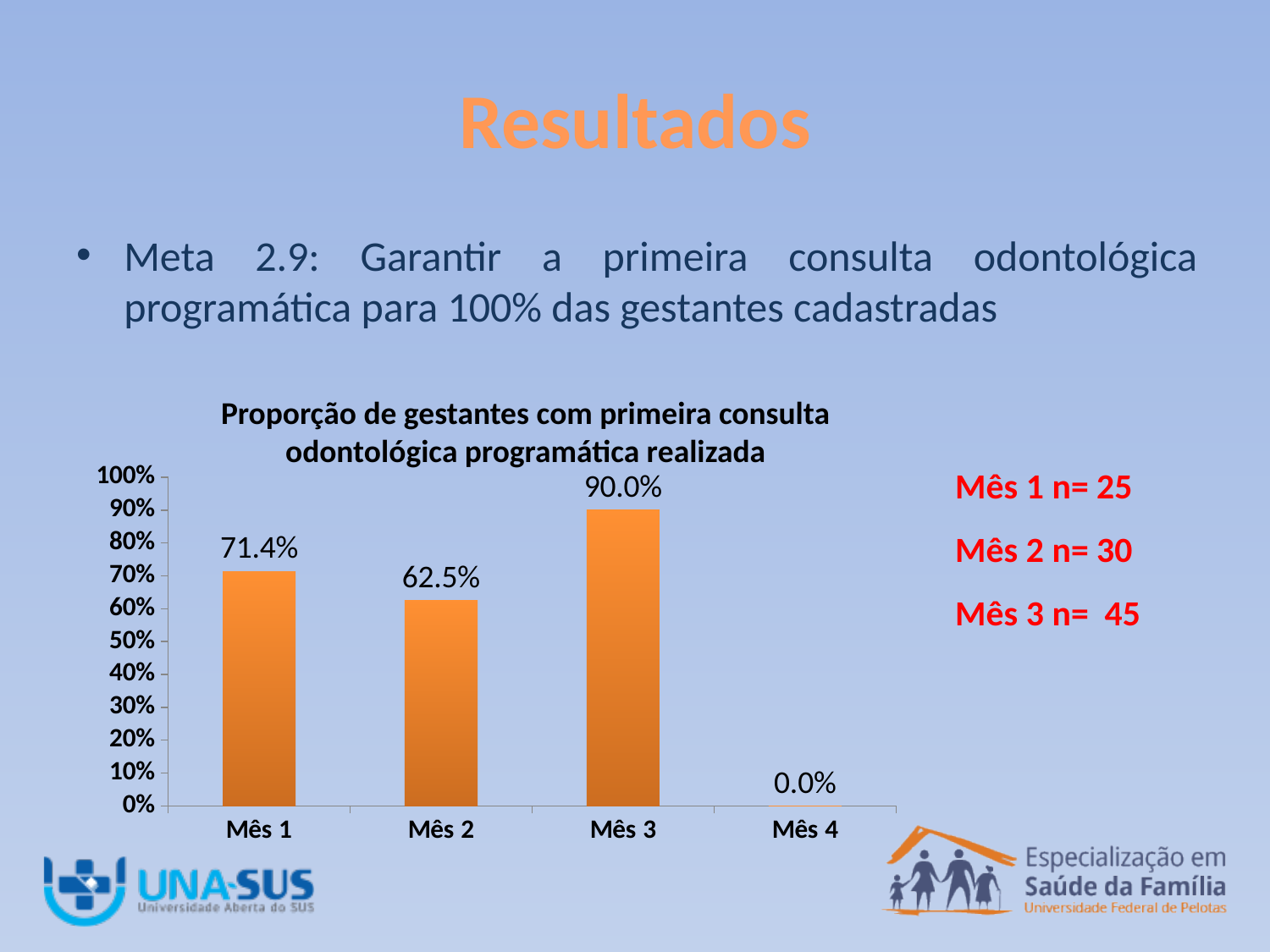
What is the value for Mês 2? 62.5% What is the value for Mês 4? 0.0% Which month has the highest value? Mês 3 Which month has the lowest value? Mês 4 What kind of chart is shown? Bar chart What is the value for Mês 3? 90.0% What is the value for Mês 1? 71.4% Which is larger, the value for Mês 1 or the value for Mês 2? Mês 1 How many months are shown on the x axis? 4 What is the difference between the values for Mês 1 and Mês 2? 8.9% What is the title of the chart? Proporção de gestantes com primeira consulta odontológica programática realizada What is the difference between the values for Mês 3 and Mês 1? 18.6%